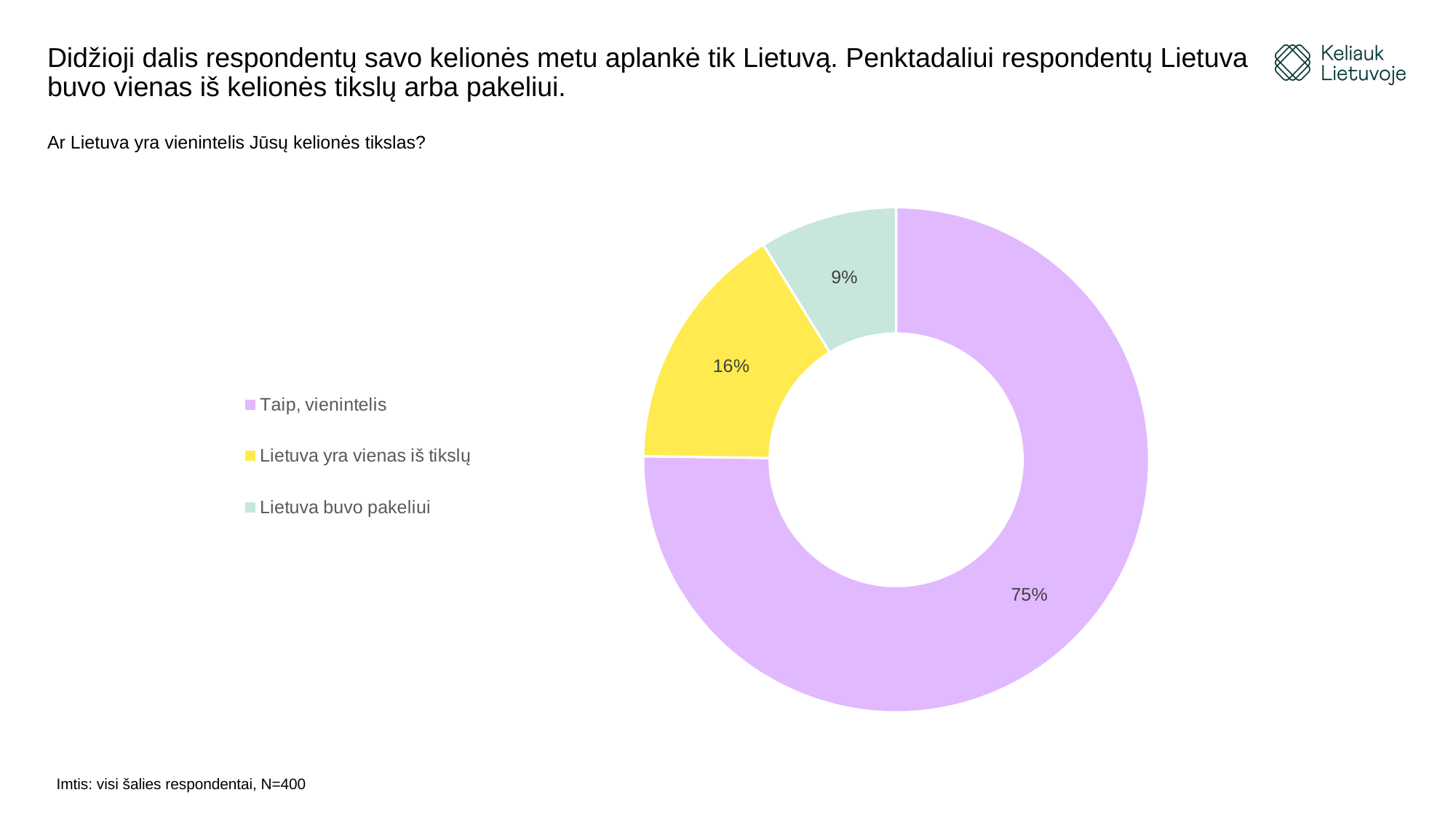
Which category has the smallest share of the chart? Lietuva buvo pakeliui What is the combined share of respondents for whom Lithuania was one of the destinations or on the way ("Lietuva yra vienas iš tikslų" plus "Lietuva buvo pakeliui")? 25% How many categories are shown in the chart? 3 What percentage of respondents answered "Taip, vienintelis"? 75% Which category has the largest share of the chart? Taip, vienintelis Which is larger: the share for "Lietuva yra vienas iš tikslų" or for "Lietuva buvo pakeliui"? Lietuva yra vienas iš tikslų What is the difference in percentage points between "Taip, vienintelis" and "Lietuva yra vienas iš tikslų"? 59 What is the difference in percentage points between "Lietuva yra vienas iš tikslų" and "Lietuva buvo pakeliui"? 7 What percentage of respondents answered "Lietuva yra vienas iš tikslų"? 16% What percentage of respondents answered "Lietuva buvo pakeliui"? 9% What colour represents "Lietuva yra vienas iš tikslų" in the chart? Yellow What kind of chart is shown on the slide? Pie chart (doughnut)